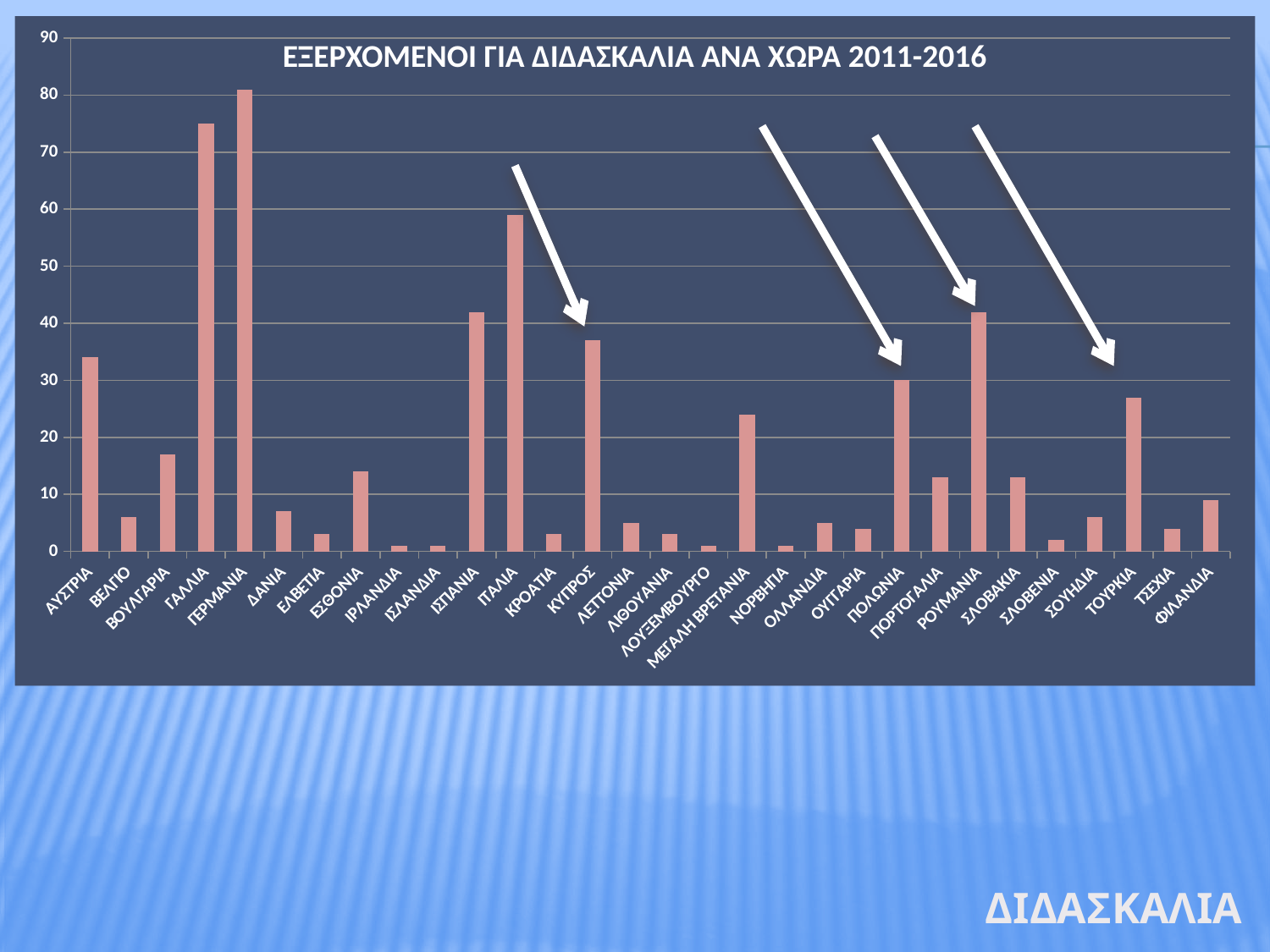
What is the title of the chart? ΕΞΕΡΧΟΜΕΝΟΙ ΓΙΑ ΔΙΔΑΣΚΑΛΙΑ ΑΝΑ ΧΩΡΑ 2011-2016 What type of chart is shown on the slide? bar chart Which country has the highest bar in the chart? ΓΕΡΜΑΝΙΑ Is the value for ΜΕΓΑΛΗ ΒΡΕΤΑΝΙΑ greater or less than 20? greater Which has the larger value, ΙΣΠΑΝΙΑ or ΤΟΥΡΚΙΑ? ΙΣΠΑΝΙΑ Is the value for ΚΥΠΡΟΣ greater or less than 40? less Is the value for ΑΥΣΤΡΙΑ greater or less than 30? greater Which has the larger value, ΚΥΠΡΟΣ or ΠΟΛΩΝΙΑ? ΚΥΠΡΟΣ Which has the larger value, ΓΑΛΛΙΑ or ΙΤΑΛΙΑ? ΓΑΛΛΙΑ How many countries are shown on the x axis of the chart? 30